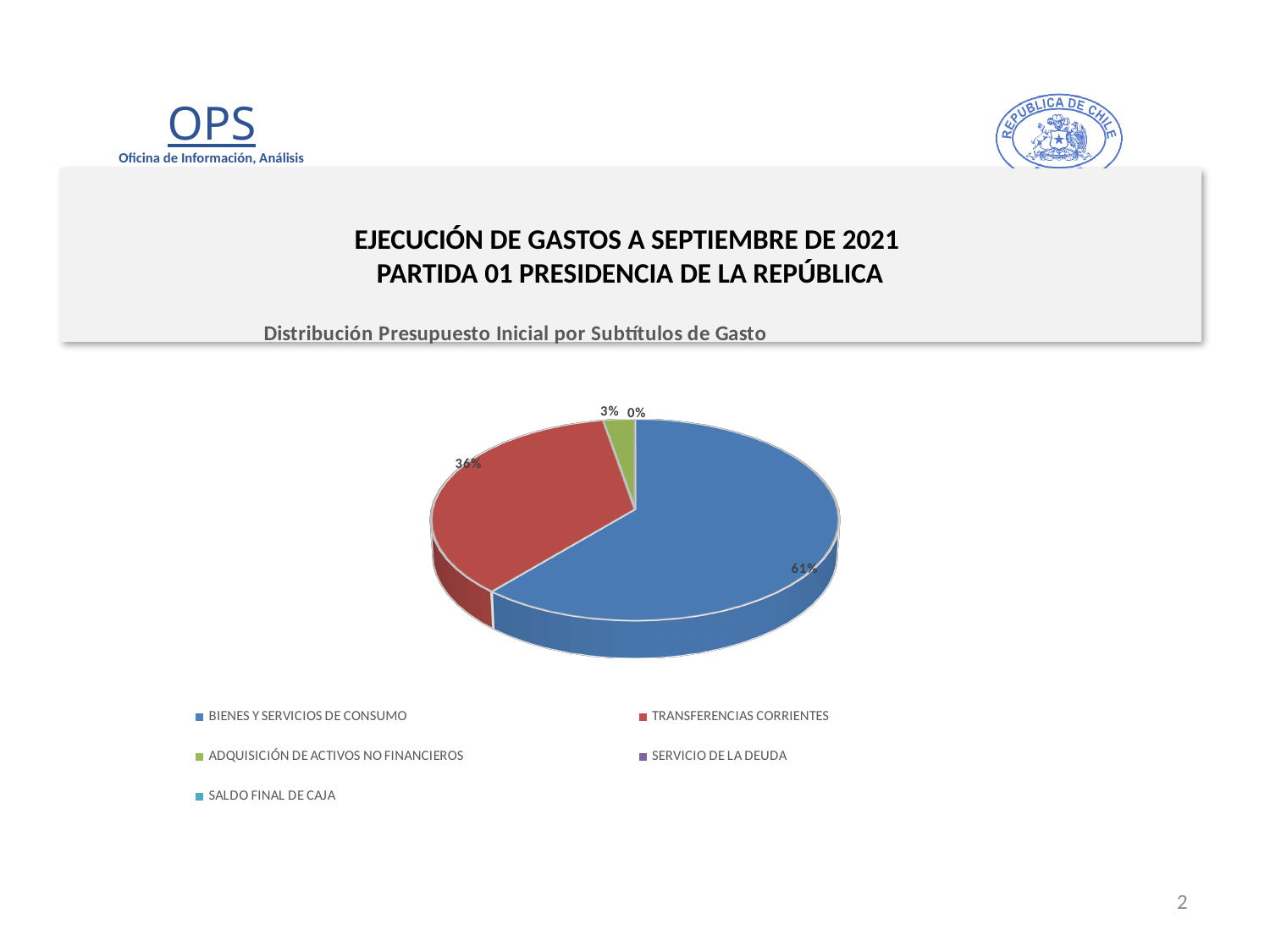
Which category has the largest slice of the pie? BIENES Y SERVICIOS DE CONSUMO Which is larger, TRANSFERENCIAS CORRIENTES or ADQUISICIÓN DE ACTIVOS NO FINANCIEROS? TRANSFERENCIAS CORRIENTES What share of the pie does BIENES Y SERVICIOS DE CONSUMO represent? 61% How many entries does the legend list? 5 What is the difference in percentage points between BIENES Y SERVICIOS DE CONSUMO and TRANSFERENCIAS CORRIENTES? 25 percentage points What is the title of the chart? Distribución Presupuesto Inicial por Subtítulos de Gasto What percentage is shown for ADQUISICIÓN DE ACTIVOS NO FINANCIEROS? 3% What is the difference in percentage points between TRANSFERENCIAS CORRIENTES and ADQUISICIÓN DE ACTIVOS NO FINANCIEROS? 33 percentage points What percentage is shown for TRANSFERENCIAS CORRIENTES? 36% What percentage is shown for BIENES Y SERVICIOS DE CONSUMO? 61% What colour is the slice for BIENES Y SERVICIOS DE CONSUMO? Blue What kind of chart is shown on the slide? Pie chart